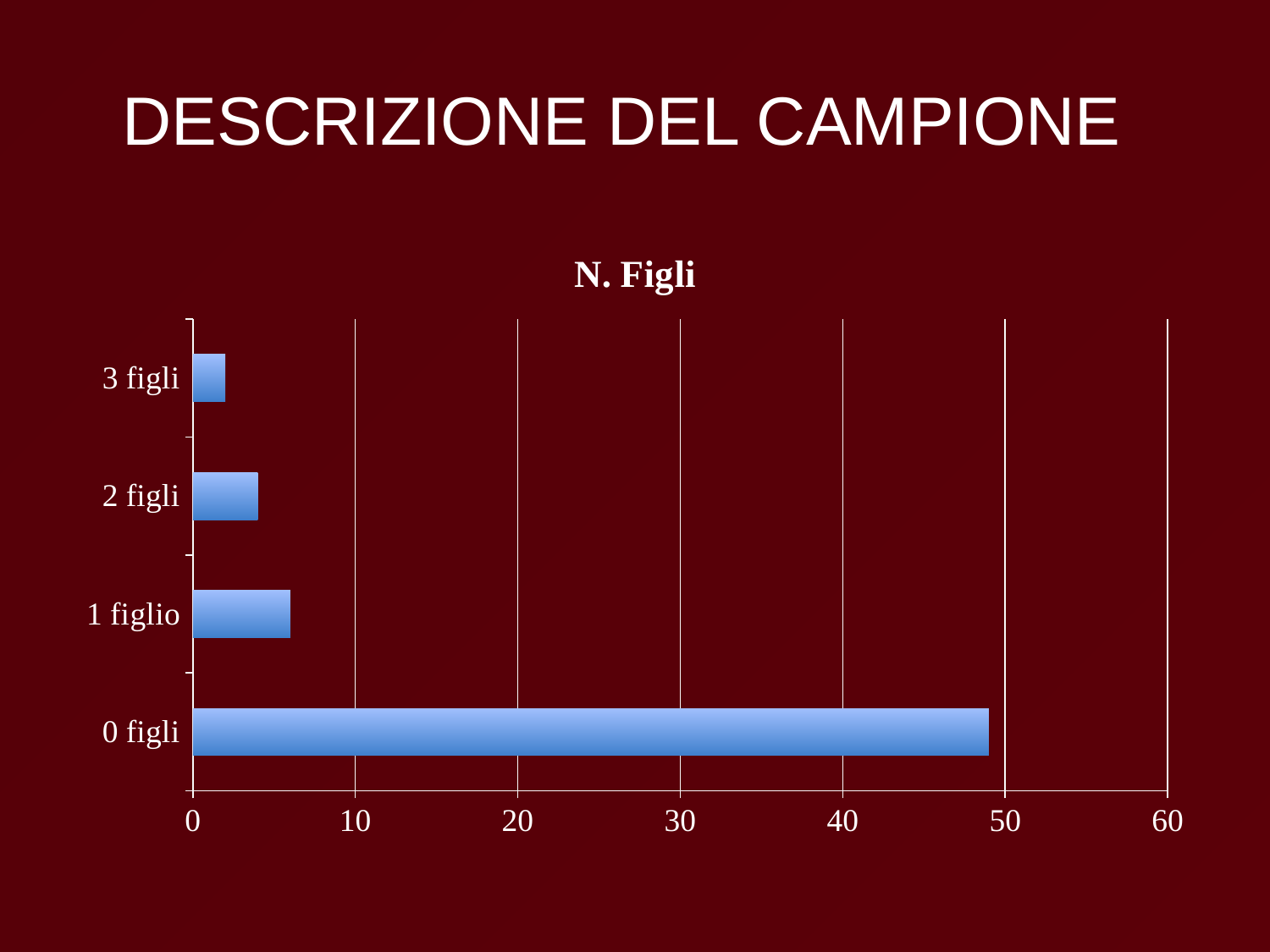
Is the value for 1 figlio greater or less than 10? less Which category has the highest value? 0 figli Which is larger, the value for 2 figli or the value for 3 figli? 2 figli What is the title of the chart? N. Figli Is the value for 3 figli greater or less than 10? less Is the value for 2 figli greater or less than 10? less What is the maximum value shown on the horizontal axis? 60 What type of chart is shown on the slide? bar chart How many categories are shown in the chart? 4 Which is larger, the value for 1 figlio or the value for 2 figli? 1 figlio Which category has the lowest value? 3 figli